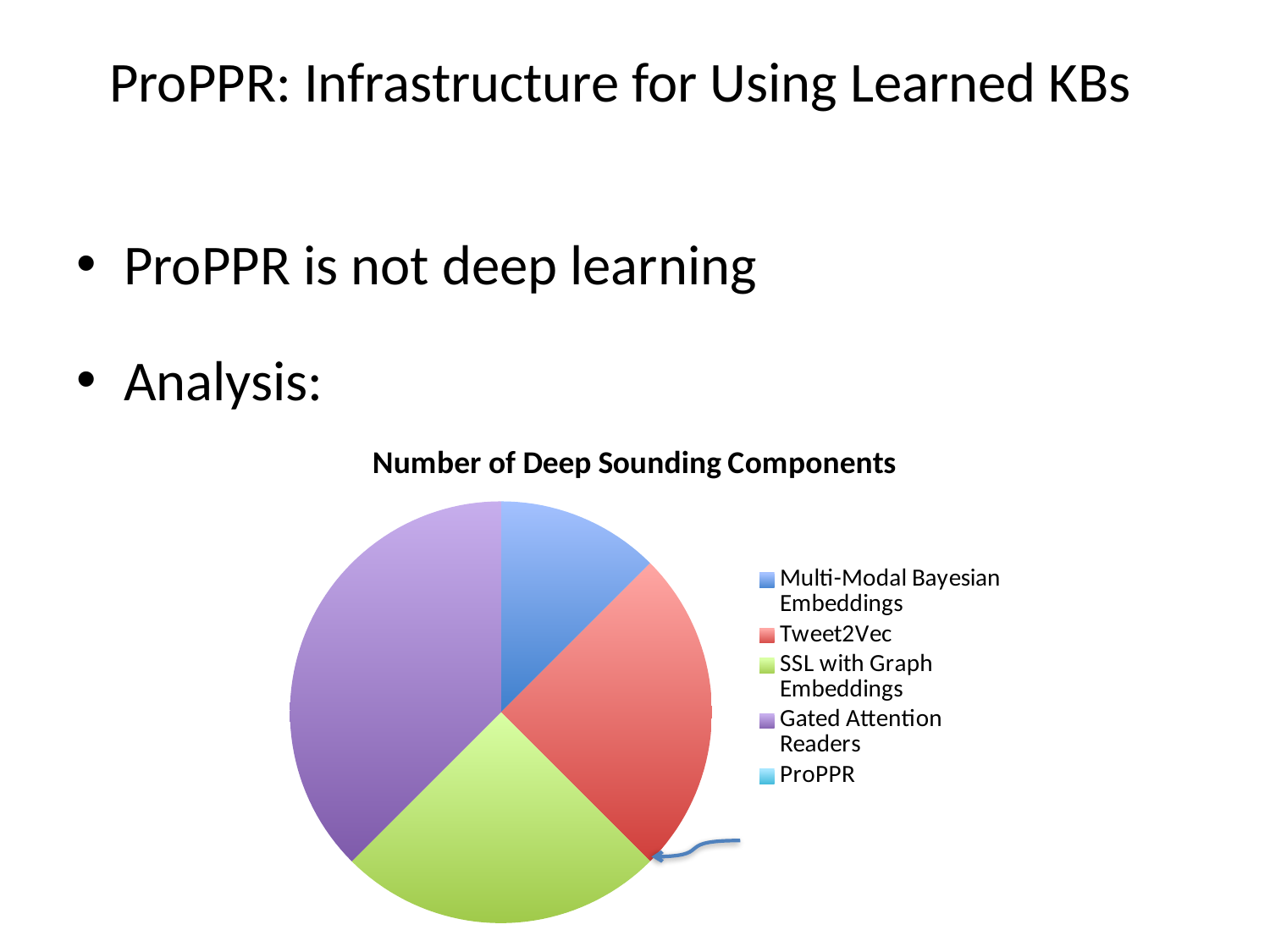
Which slice is larger, Tweet2Vec or Multi-Modal Bayesian Embeddings? Tweet2Vec How many entries does the chart's legend list? 5 Which slice is larger, Gated Attention Readers or Multi-Modal Bayesian Embeddings? Gated Attention Readers Which slice is larger, SSL with Graph Embeddings or ProPPR? SSL with Graph Embeddings Which category has the largest slice of the pie? Gated Attention Readers What kind of chart is shown on the slide? pie chart What colour is the Gated Attention Readers slice? purple What is the title of the chart? Number of Deep Sounding Components Which category has the smallest slice of the pie? ProPPR